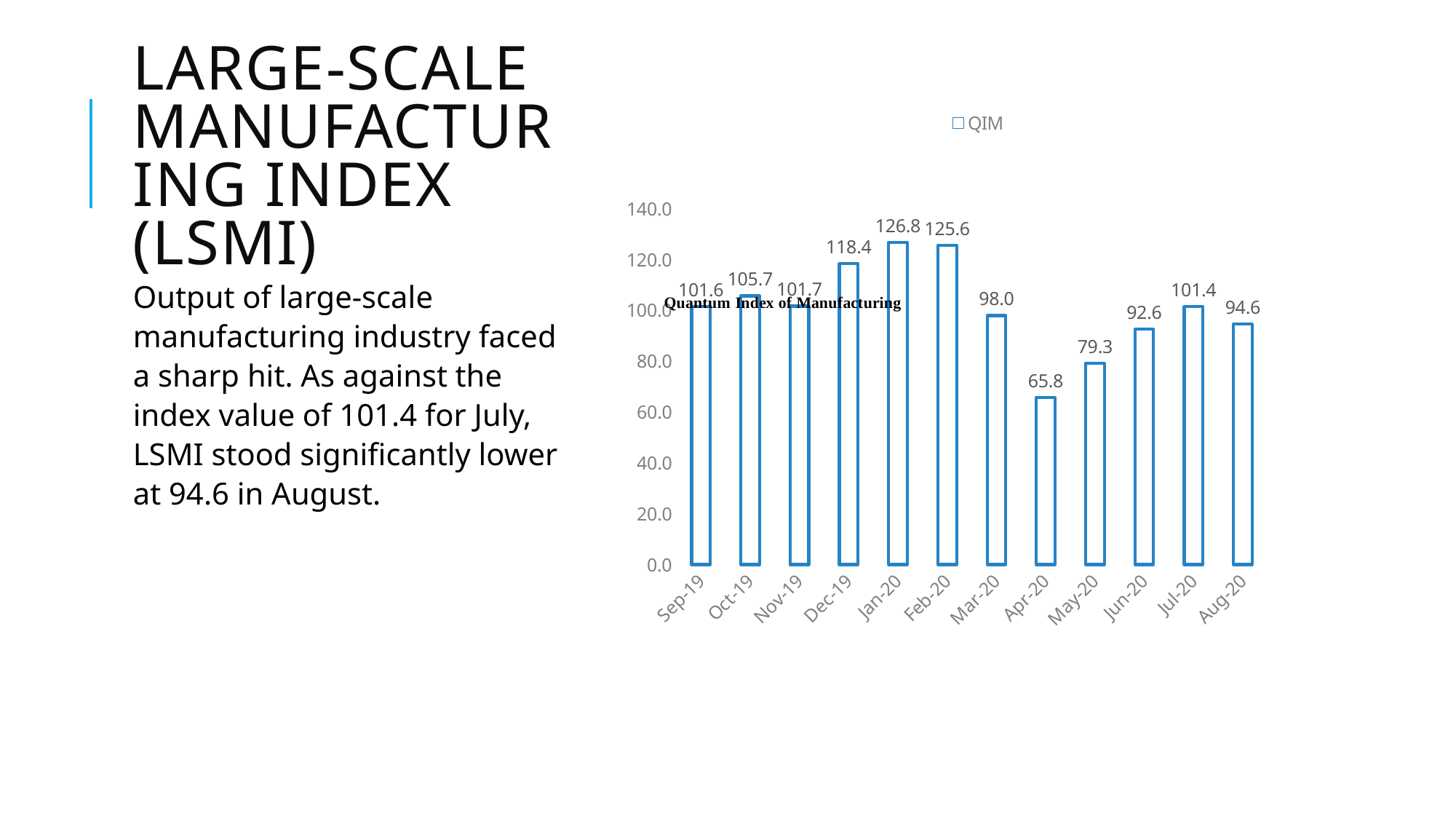
What kind of chart is shown on the slide? bar chart Which is larger, the QIM value for Dec-19 or for Mar-20? Dec-19 What is the QIM value for Jan-20? 126.8 How many months are shown on the x axis of the chart? 12 Which month has the highest QIM value? Jan-20 What is the QIM value for Aug-20? 94.6 Is the QIM value for May-20 greater or less than 100.0? less Which month has the lowest QIM value? Apr-20 What is the name of the series shown in the chart legend? QIM What is the QIM value for Apr-20? 65.8 How many series does the chart legend list? 1 What is the difference between the QIM values for Jul-20 and Aug-20? 6.8